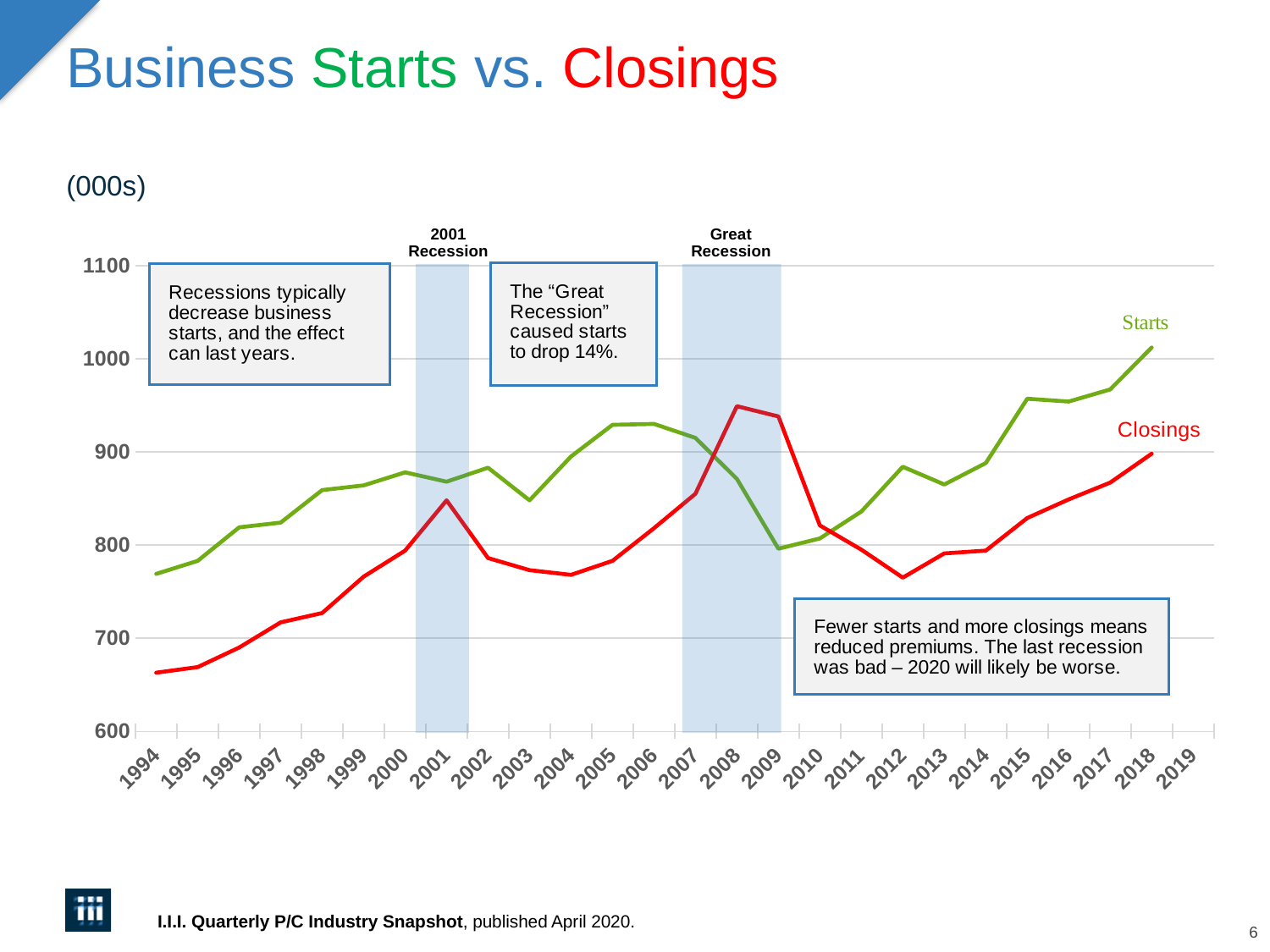
Is the value for Starts in 2018 greater or less than 1000? greater Is the value for Closings in 2008 greater or less than 900? greater Is the value for Closings in 1994 greater or less than 700? less In 2008, which series has the higher value, Starts or Closings? Closings What is the title of the chart on the slide? Business Starts vs. Closings How many data series are plotted on the chart? 2 Which colour is used for the Starts line? Green Do the Starts values rise or fall from 2009 to 2018? Rise In 2018, which series has the higher value, Starts or Closings? Starts What kind of chart is shown on the slide? Line chart